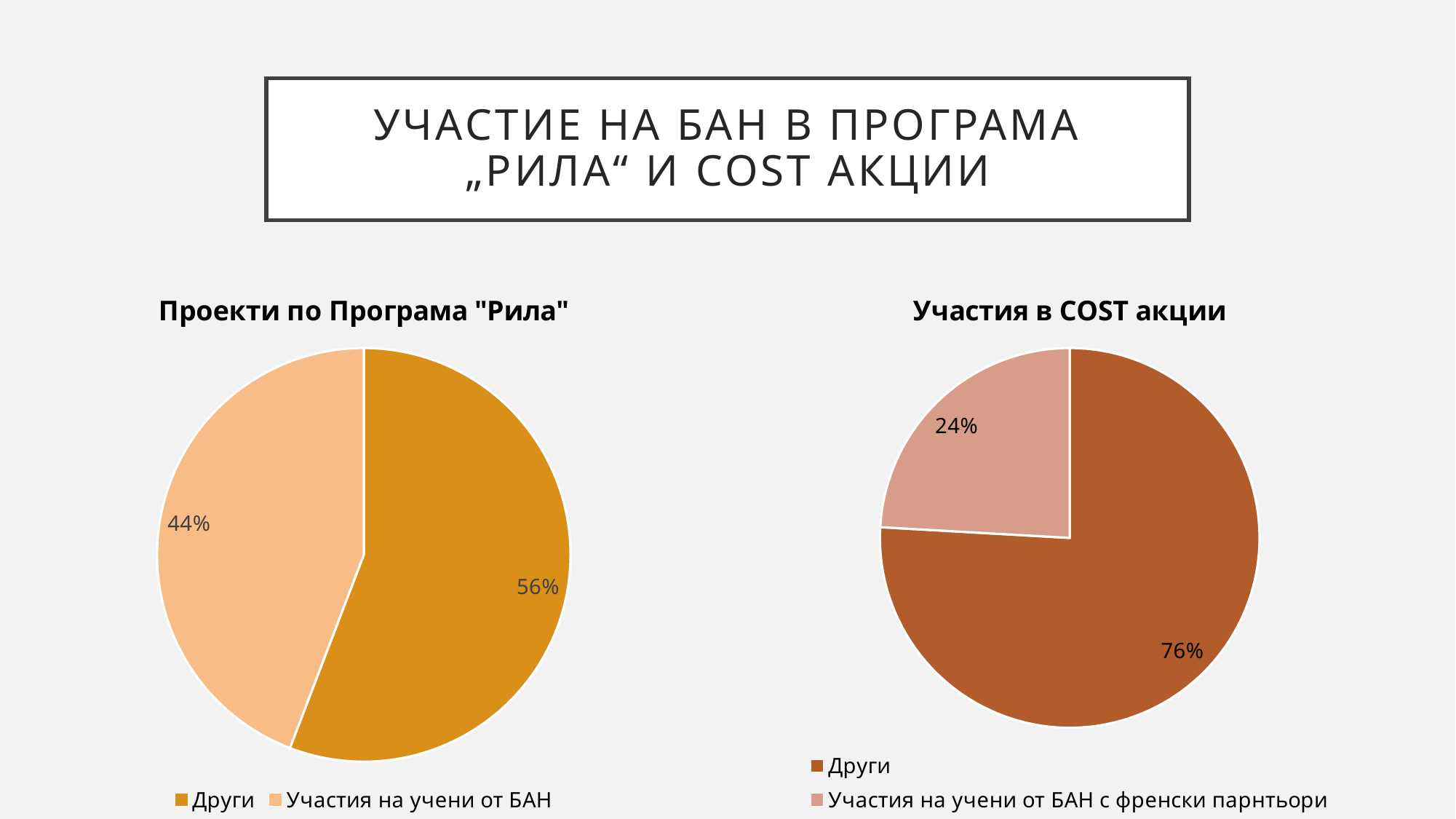
In the chart titled 'Участия в COST акции', what share of the pie is 'Други'? 76% How many slices does the chart titled 'Участия в COST акции' have? 2 In the chart titled 'Участия в COST акции', which slice is the smallest? Участия на учени от БАН с френски парнтьори What kind of chart is the chart titled 'Проекти по Програма "Рила"'? Pie chart In the chart titled 'Участия в COST акции', what is the difference in percentage points between 'Други' and 'Участия на учени от БАН с френски парнтьори'? 52 In the chart titled 'Проекти по Програма "Рила"', what share of the pie is 'Други'? 56% In the chart titled 'Проекти по Програма "Рила"', which slice is the largest? Други How many entries does the legend of the chart titled 'Проекти по Програма "Рила"' list? 2 In the chart titled 'Участия в COST акции', what share of the pie is 'Участия на учени от БАН с френски парнтьори'? 24% In the chart titled 'Проекти по Програма "Рила"', what is the difference in percentage points between 'Други' and 'Участия на учени от БАН'? 12 In the chart titled 'Участия в COST акции', which is larger: 'Други' or 'Участия на учени от БАН с френски парнтьори'? Други